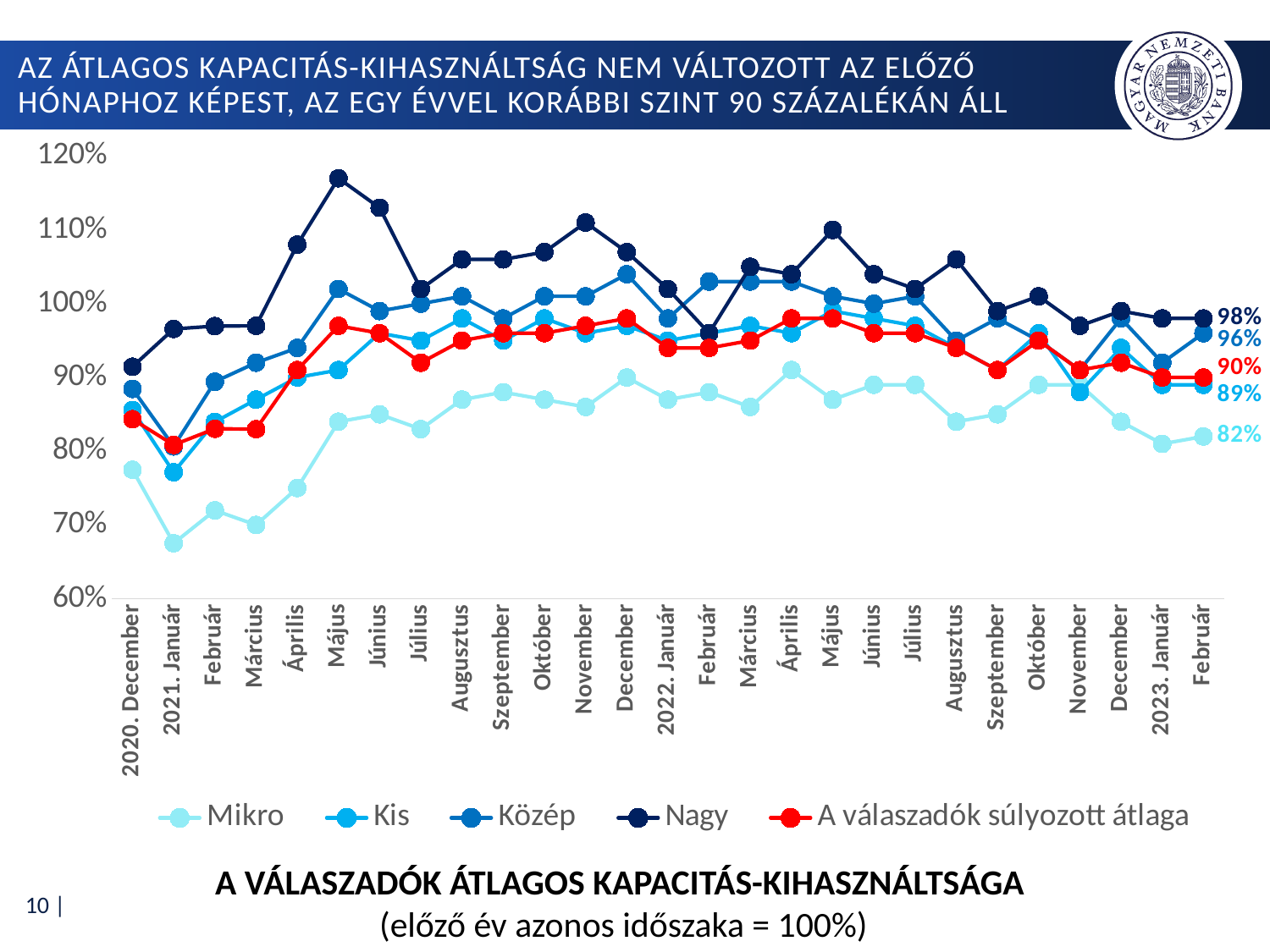
What is the value for A válaszadók súlyozott átlaga in 2023. Február? 90% Is the value for Nagy in 2021. Május greater or less than 110%? greater What is the difference between the Nagy and Mikro values in 2023. Február? 16 percentage points What is the value for Kis in 2023. Február? 89% Which series has the highest value in 2023. Február? Nagy Which series has the lowest value in 2023. Február? Mikro What is the value for Közép in 2023. Február? 96% What type of chart is shown on the slide? line chart What is the value for Nagy in 2023. Február? 98% What is the value for Mikro in 2023. Február? 82% How many series does the legend list? 5 Is the value for Mikro in 2021. Január greater or less than 70%? less